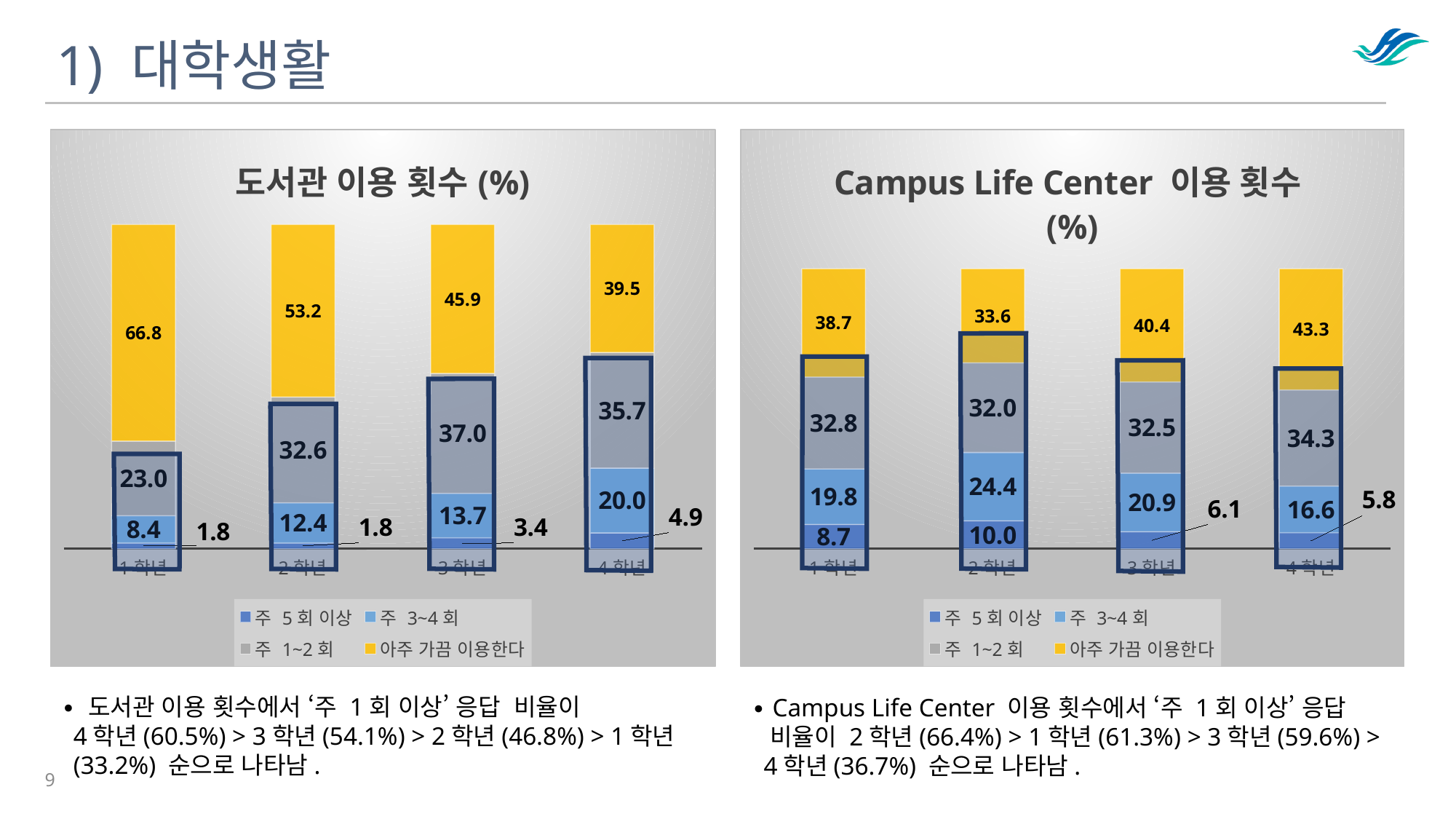
In the Campus Life Center 이용 횟수 (%) chart, what is the value of 주 3~4 회 for 2 학년? 24.4 In the Campus Life Center 이용 횟수 (%) chart, which is larger: the 아주 가끔 이용한다 value for 4 학년 or for 2 학년? 4 학년 In the Campus Life Center 이용 횟수 (%) chart, what is the value of 주 5 회 이상 for 3 학년? 6.1 In the 도서관 이용 횟수 (%) chart, what is the value of 아주 가끔 이용한다 for 1 학년? 66.8 What kind of chart is the 도서관 이용 횟수 (%) chart? stacked bar chart In the Campus Life Center 이용 횟수 (%) chart, which grade has the lowest value for 주 5 회 이상? 4 학년 How many series does the legend of the Campus Life Center 이용 횟수 (%) chart list? 4 In the 도서관 이용 횟수 (%) chart, what is the value of 주 1~2 회 for 3 학년? 37.0 In the 도서관 이용 횟수 (%) chart, which grade has the highest value for 주 3~4 회? 4 학년 In the 도서관 이용 횟수 (%) chart, what is the value of 주 5 회 이상 for 4 학년? 4.9 In the 도서관 이용 횟수 (%) chart, does the 아주 가끔 이용한다 value rise or fall from 1 학년 to 4 학년? fall In the 도서관 이용 횟수 (%) chart, what is the difference between the 아주 가끔 이용한다 values for 1 학년 and 4 학년? 27.3